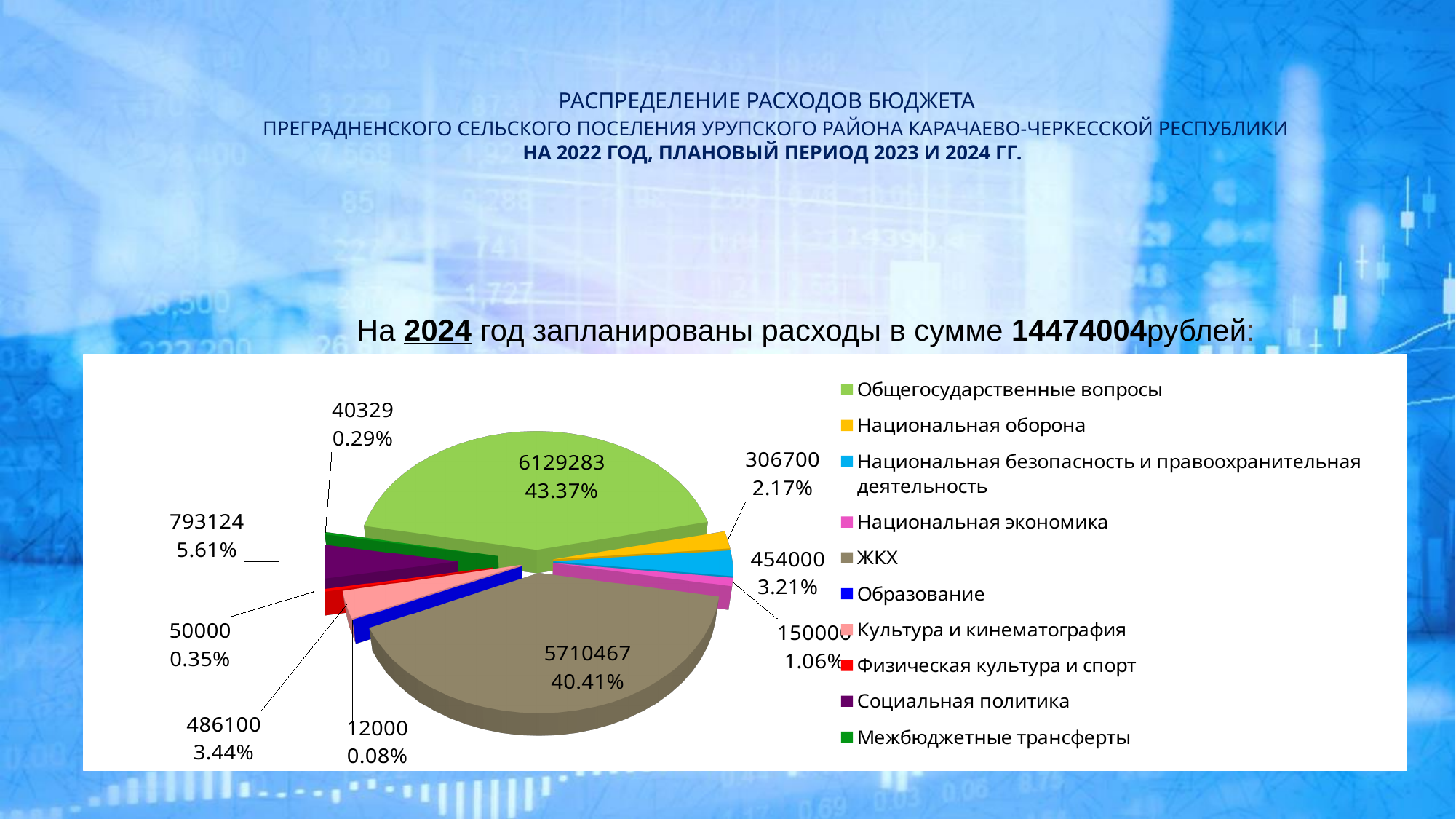
Which category has the largest slice of the pie chart? Общегосударственные вопросы What total planned expenditure for 2024 is stated above the chart? 14474004 Which is larger, the value for Национальная безопасность и правоохранительная деятельность or the value for Национальная оборона? Национальная безопасность и правоохранительная деятельность What share of the pie does Культура и кинематография account for? 3.44% What share of the pie does ЖКХ account for? 40.41% What is the difference between the values for Общегосударственные вопросы and ЖКХ? 418816 How many categories does the legend of the pie chart list? 10 What value is shown for Общегосударственные вопросы in the pie chart? 6129283 What value is shown for ЖКХ in the pie chart? 5710467 What share of the pie does Социальная политика account for? 5.61% What kind of chart is shown on the slide? pie chart Which category has the smallest slice of the pie chart? Образование